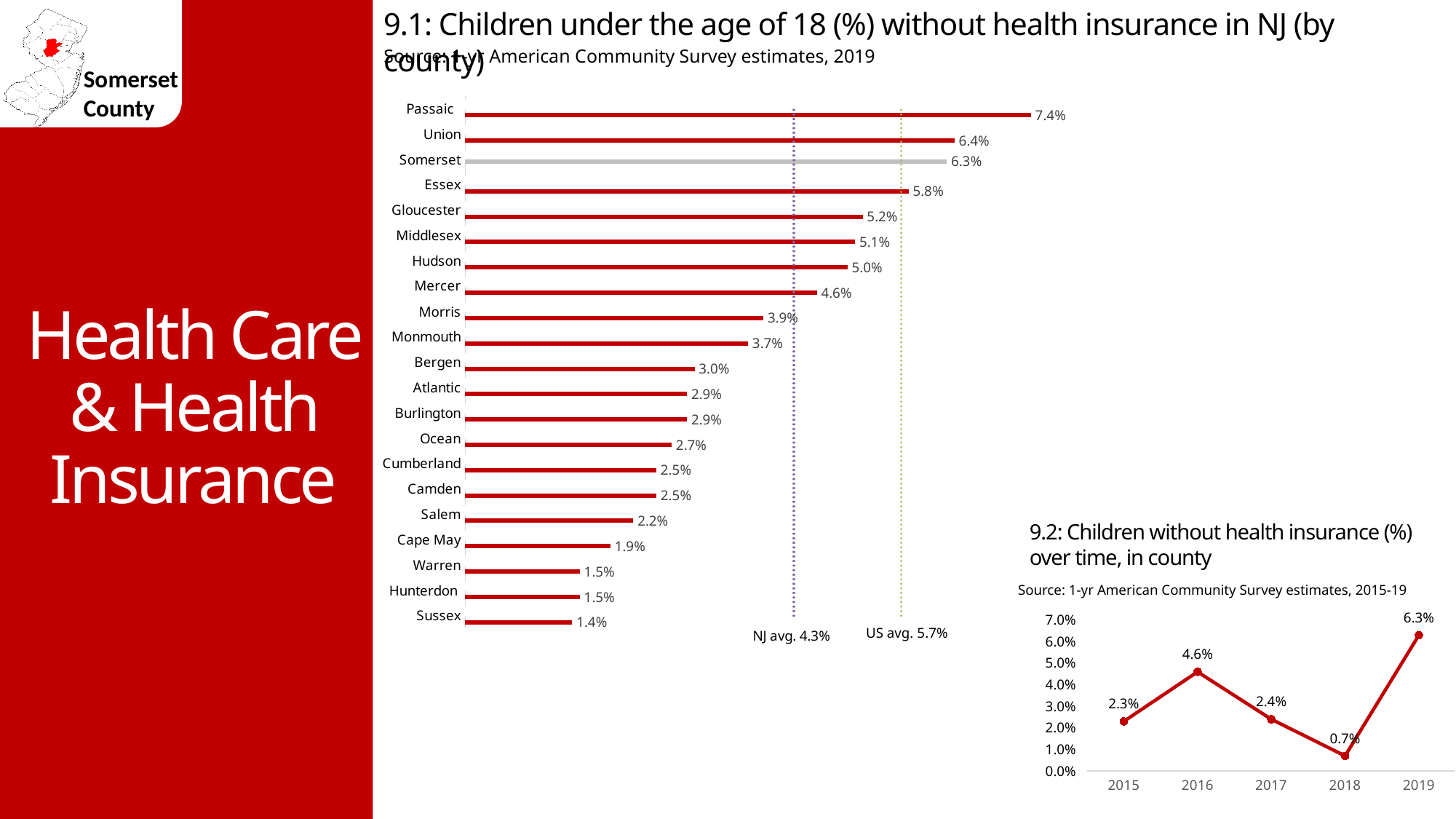
What kind of chart is chart 9.2 (children without health insurance over time)? Line chart In chart 9.2 (children without health insurance over time), what is the value for 2018? 0.7% In chart 9.1 (children under 18 without health insurance by county), how many counties are shown? 21 In chart 9.1 (children under 18 without health insurance by county), which county has the lowest value? Sussex In chart 9.1 (children under 18 without health insurance by county), what is the value for Somerset? 6.3% What kind of chart is chart 9.1 (children under 18 without health insurance by county)? Bar chart In chart 9.1 (children under 18 without health insurance by county), what is the NJ average shown by the dotted line? 4.3% In chart 9.2 (children without health insurance over time), which year has the highest value? 2019 In chart 9.1 (children under 18 without health insurance by county), which is larger, the value for Mercer or the value for Morris? Mercer In chart 9.1 (children under 18 without health insurance by county), what is the difference between Passaic and Union? 1.0% In chart 9.2 (children without health insurance over time), what is the difference between 2019 and 2018? 5.6% In chart 9.1 (children under 18 without health insurance by county), which county has the highest value? Passaic